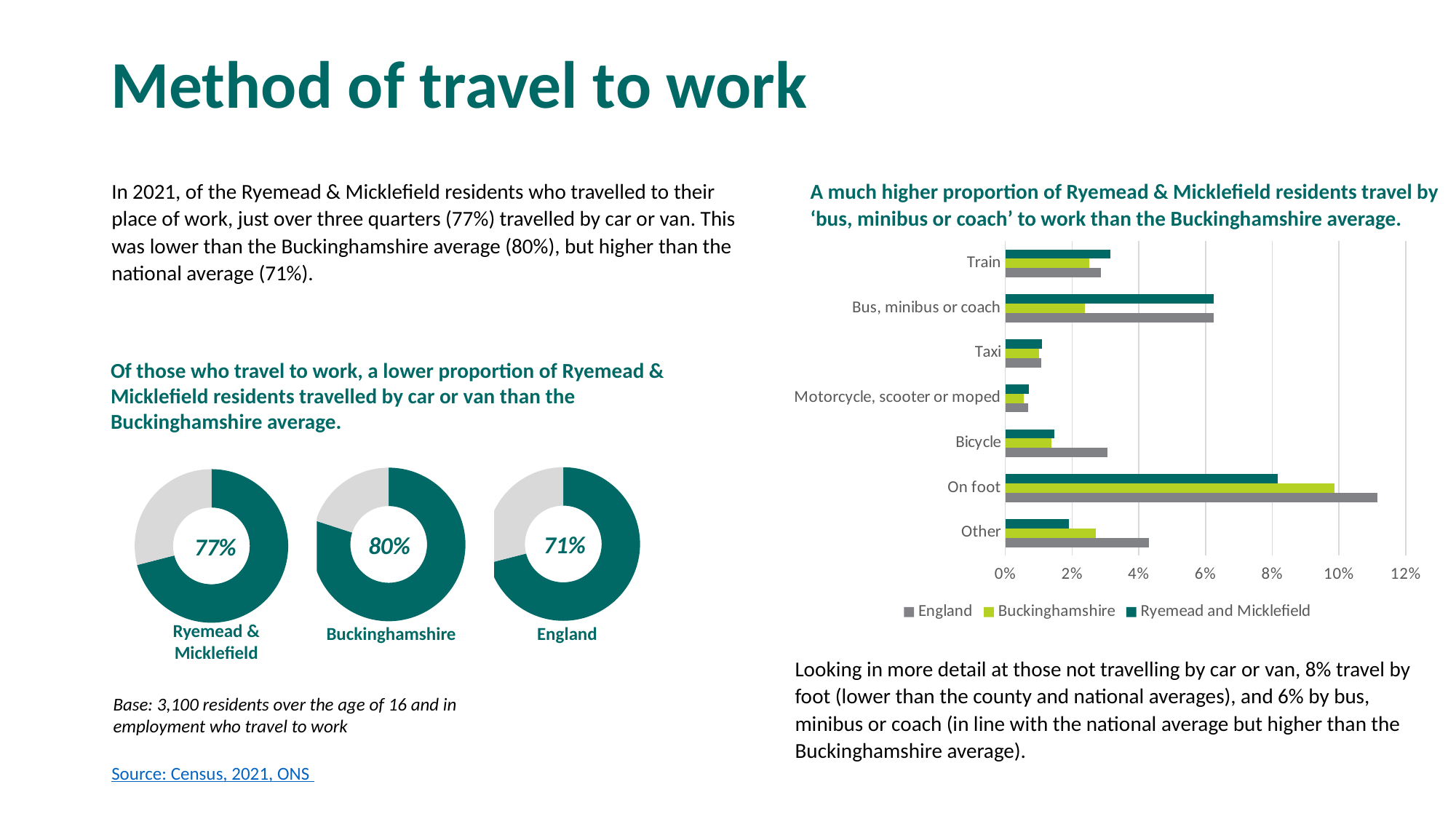
In the bar chart on the right, which category has the lowest England value? Motorcycle, scooter or moped In the donut charts, what percentage of Ryemead & Micklefield residents travelled to work by car or van? 77% What kind of chart is the chart on the right showing methods of travel such as Train and Bicycle? Bar chart In the donut charts, what is the value shown for England? 71% Among the three donut charts, which area has the lowest percentage travelling by car or van? England How many series does the legend of the bar chart on the right list? 3 In the donut charts, what is the value shown for Buckinghamshire? 80% In the donut charts, what is the difference between the Buckinghamshire value and the England value? 9% In the bar chart on the right, for Bus, minibus or coach, which is larger: the Buckinghamshire value or the Ryemead and Micklefield value? Ryemead and Micklefield How many travel method categories are shown in the bar chart on the right? 7 In the bar chart on the right, is the England value for On foot greater or less than 10%? greater Among the three donut charts, which area has the highest percentage travelling by car or van? Buckinghamshire